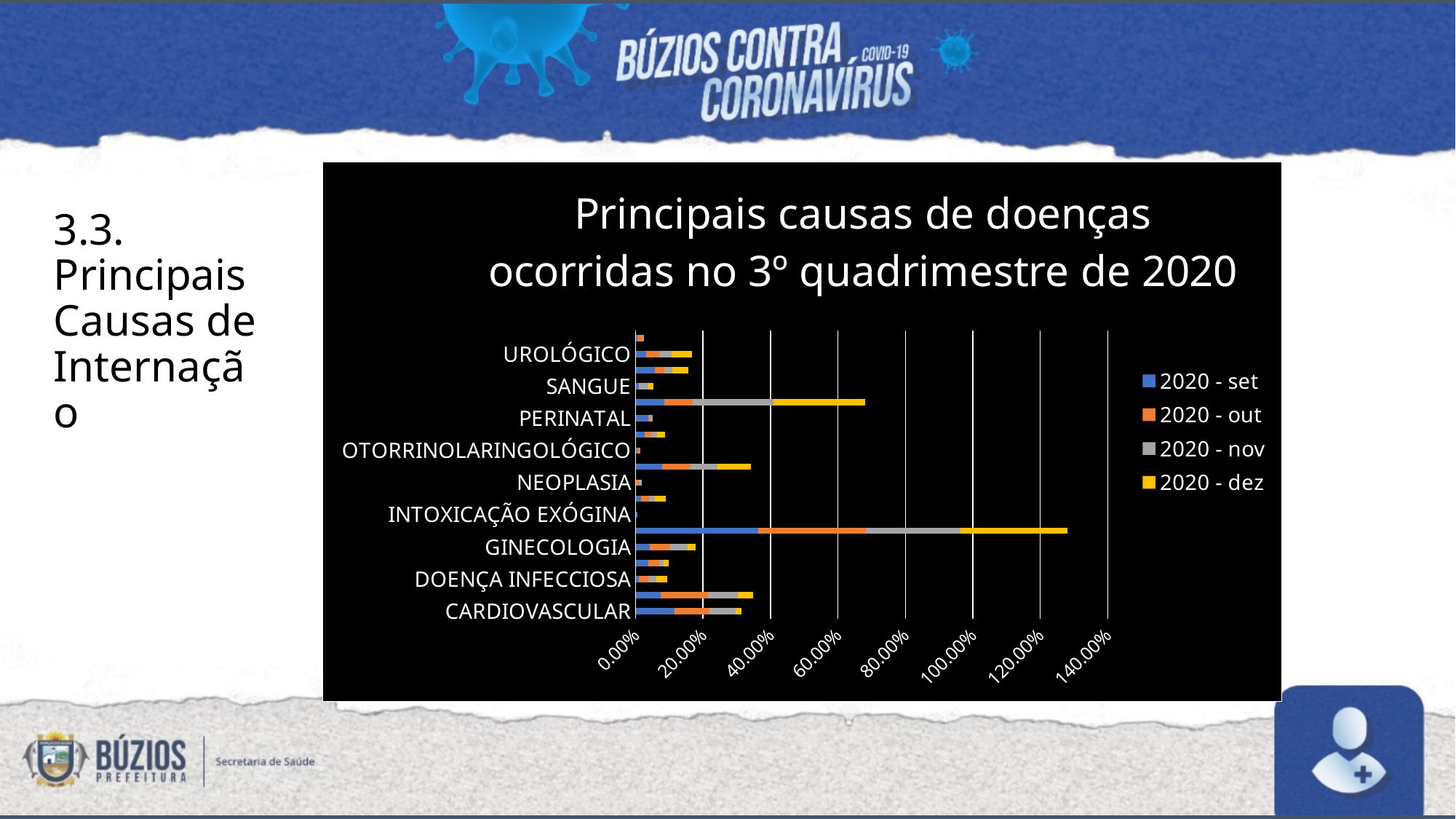
What is the title of the chart? Principais causas de doenças ocorridas no 3º quadrimestre de 2020 Which has the longer bar, DOENÇA INFECCIOSA or NEOPLASIA? DOENÇA INFECCIOSA Which has the longer bar, CARDIOVASCULAR or SANGUE? CARDIOVASCULAR Is the total value of the CARDIOVASCULAR bar greater or less than 40.00%? less Which series is shown in yellow in the legend? 2020 - dez What kind of chart is shown on the slide? Stacked bar chart Is the total value of the SANGUE bar greater or less than 20.00%? less How many series does the legend list? 4 Which has the longer bar, CARDIOVASCULAR or OTORRINOLARINGOLÓGICO? CARDIOVASCULAR Is the total value of the CARDIOVASCULAR bar greater or less than 20.00%? greater